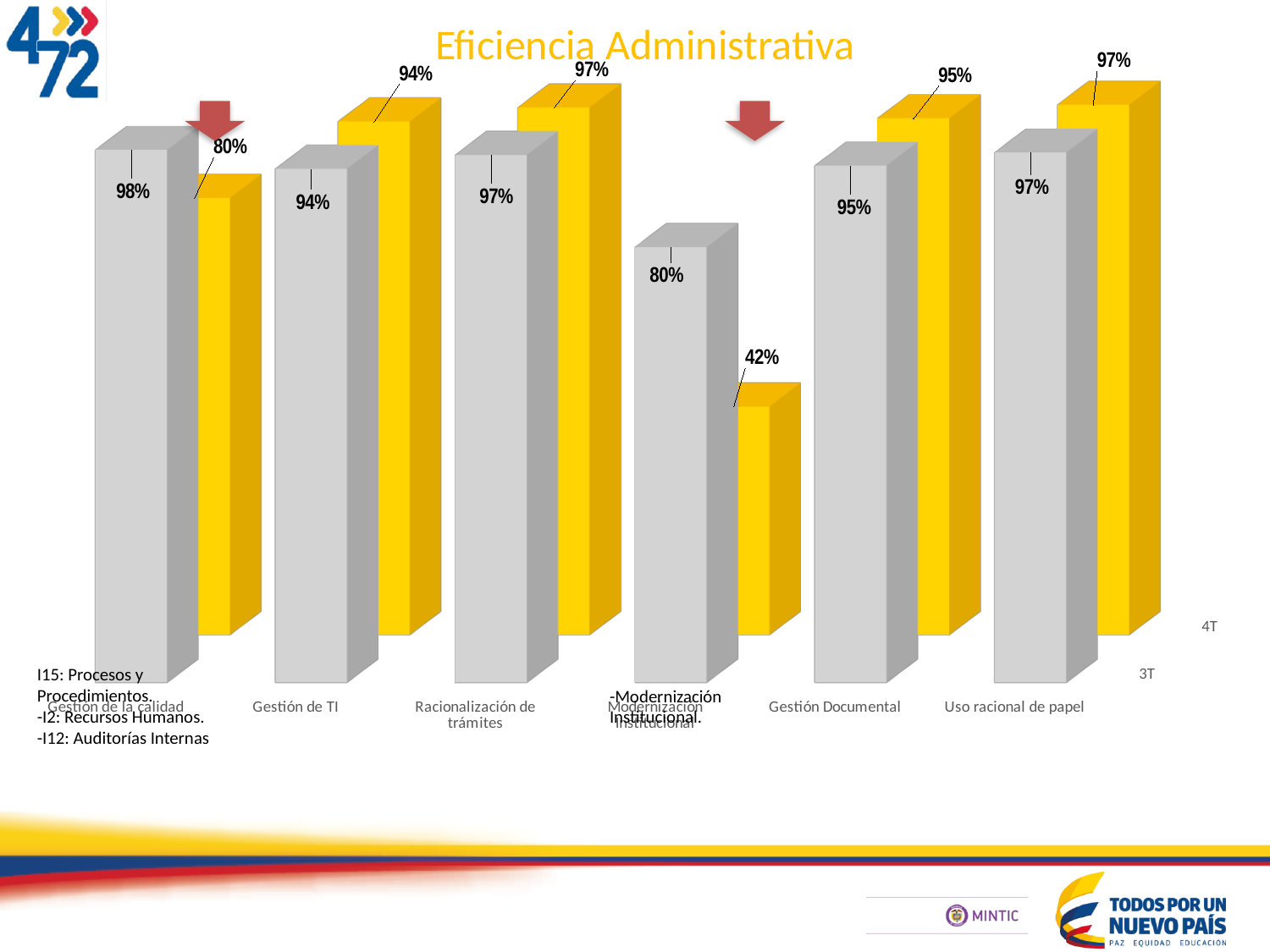
What is the 3T value for Gestión de la calidad? 98% What is the 3T value for Gestión Documental? 95% What is the title of the chart? Eficiencia Administrativa Which category has the lowest 4T value? Modernización Institucional What is the 4T value for Modernización Institucional? 42% What is the 4T value for Gestión de la calidad? 80% What is the 3T value for Modernización Institucional? 80% Which is larger for Gestión de la calidad, the 3T value or the 4T value? 3T What type of chart is shown on the slide? bar chart What is the difference between the 3T and 4T values for Modernización Institucional? 38% How many categories are shown on the x axis of the chart? 6 Which category has the highest 3T value? Gestión de la calidad